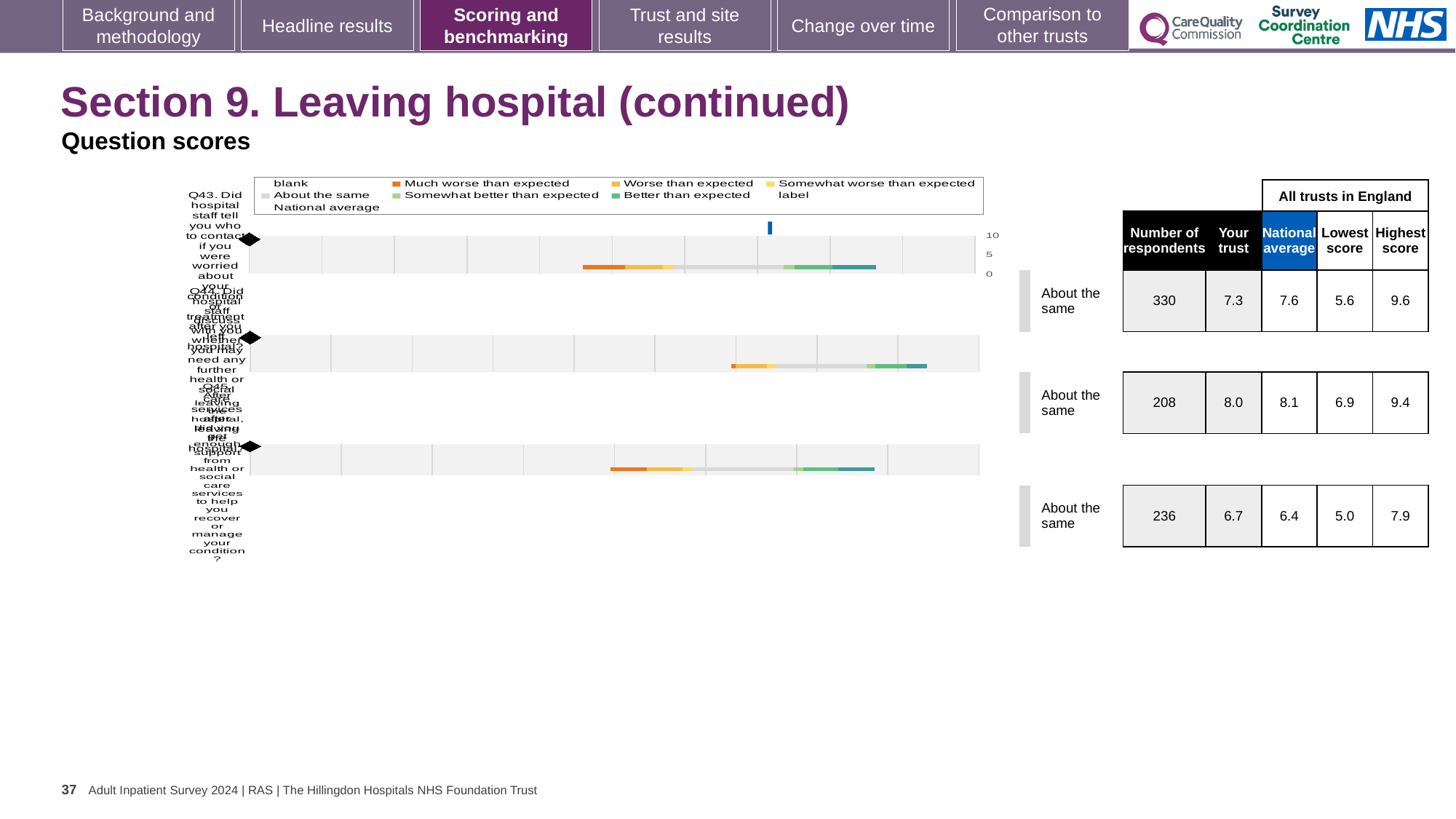
For the top chart (Q43), which is larger: the 'Your trust' score or the national average? National average For the middle chart, what is the 'Your trust' score shown in the table beside it? 8.0 What benchmark category is shown next to the top chart (Q43)? About the same For the top chart (Q43), what is the 'Your trust' score shown in the table beside it? 7.3 Which of the three charts has the highest 'Your trust' score in its table? the middle chart In the chart legend, what colour represents 'Much worse than expected'? orange For the top chart (Q43), what is the national average score shown in the table beside it? 7.6 For the top chart (Q43), how many respondents are listed in the table beside it? 330 How many benchmark bar charts are shown on the slide? 3 What kind of chart is used to show the question scores on this slide? bar chart For the bottom chart, what is the difference between the highest score (7.9) and the lowest score (5.0) in the table beside it? 2.9 For the bottom chart, what is the highest score across all trusts in England shown in the table beside it? 7.9